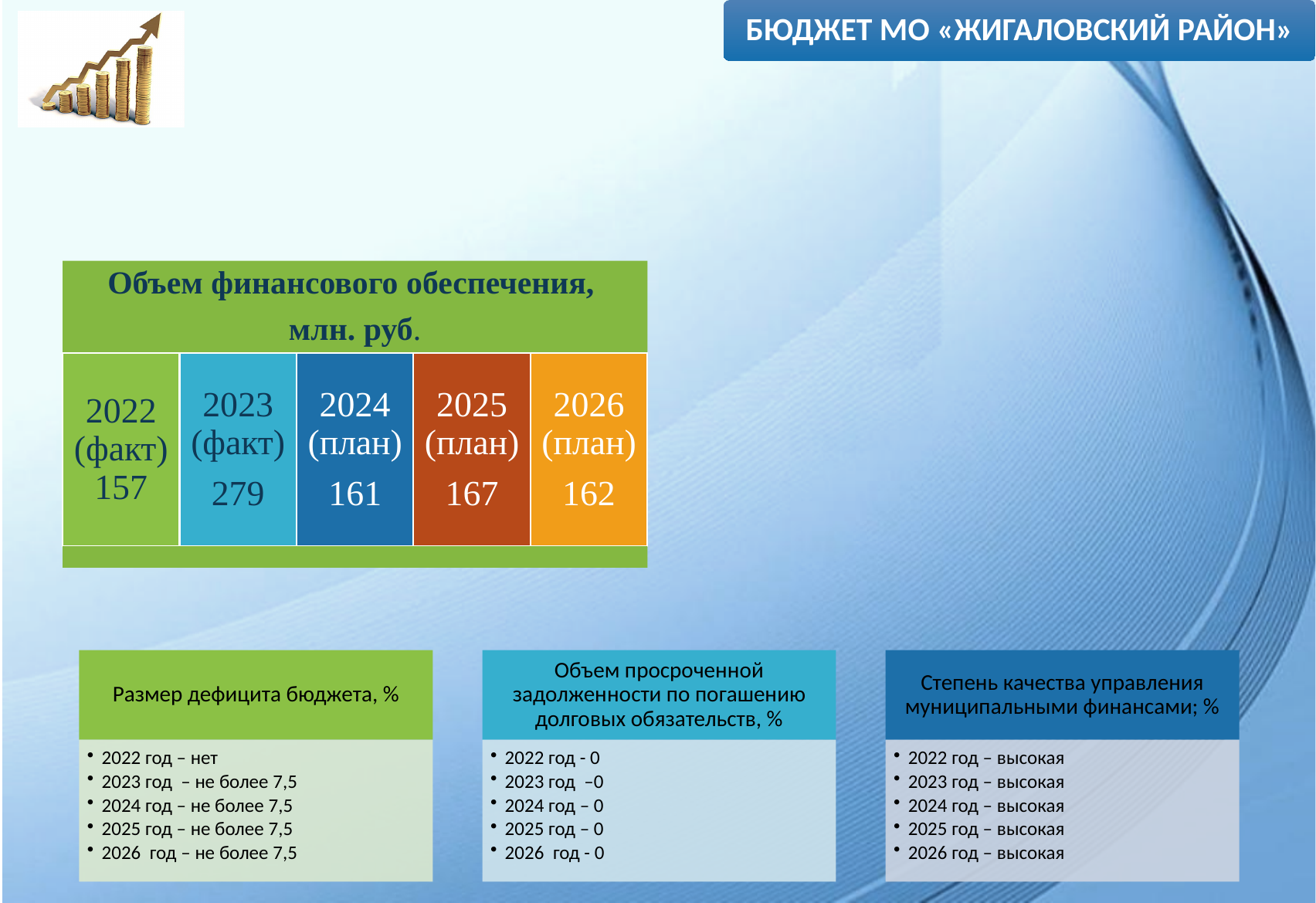
In the block 'Объем финансового обеспечения, млн. руб.', what is the value for 2024 (план)? 161 In the block 'Объем финансового обеспечения, млн. руб.', which year has the lowest value? 2022 (факт) In the block 'Объем финансового обеспечения, млн. руб.', what is the value for 2023 (факт)? 279 In the block 'Объем финансового обеспечения, млн. руб.', what is the value for 2022 (факт)? 157 In the block 'Объем финансового обеспечения, млн. руб.', which is larger: the value for 2025 (план) or 2026 (план)? 2025 (план) In the block 'Объем финансового обеспечения, млн. руб.', what colour is the 2026 (план) cell? Orange In the block 'Объем финансового обеспечения, млн. руб.', which year has the highest value? 2023 (факт) In the block 'Объем финансового обеспечения, млн. руб.', what is the difference between the 2025 (план) and 2024 (план) values? 6 In the block 'Объем финансового обеспечения, млн. руб.', what is the value for 2026 (план)? 162 In the block 'Объем финансового обеспечения, млн. руб.', what is the difference between the 2023 (факт) and 2022 (факт) values? 122 How many years are shown in the block 'Объем финансового обеспечения, млн. руб.'? 5 In the block 'Объем финансового обеспечения, млн. руб.', what is the value for 2025 (план)? 167